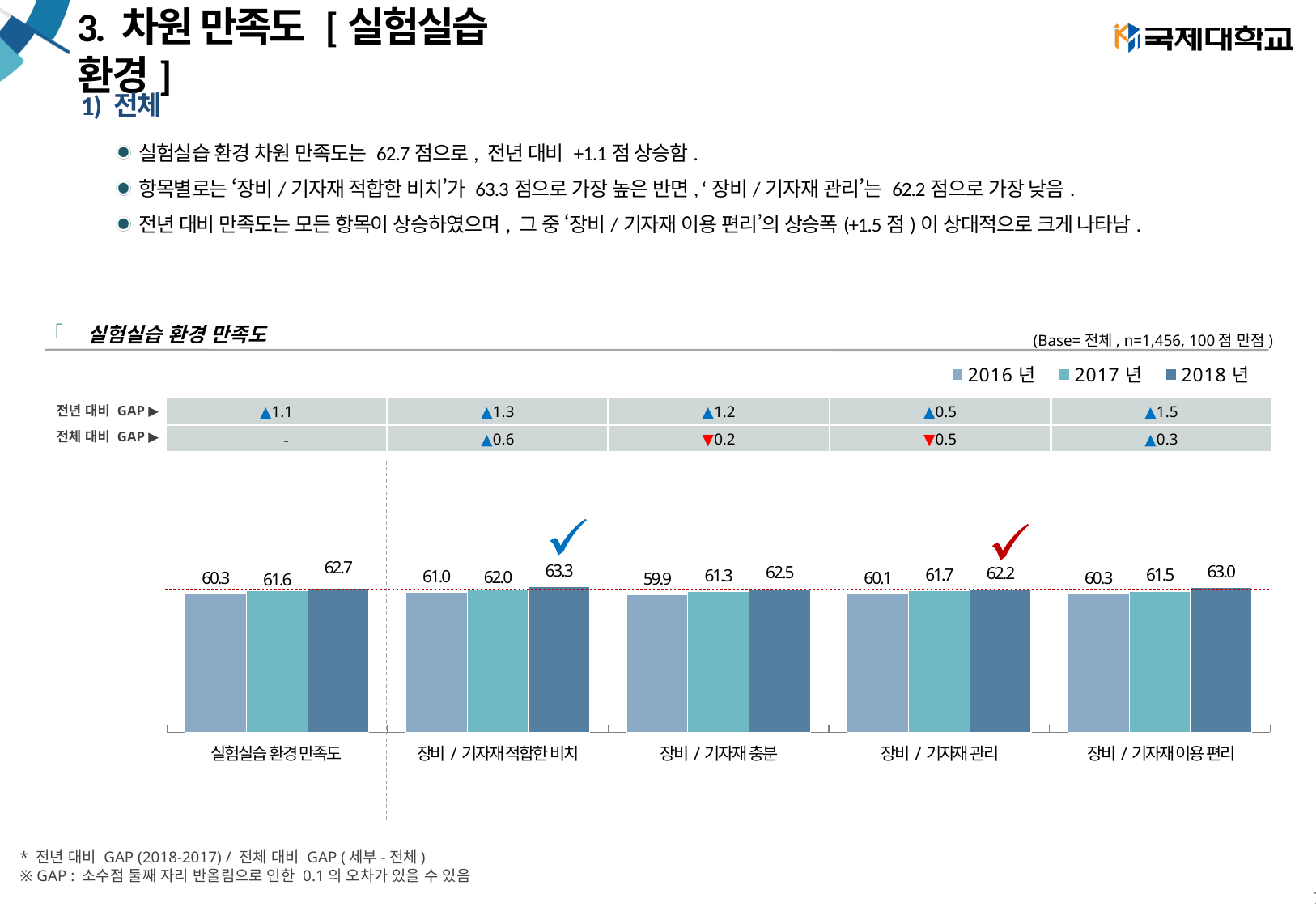
Which is larger, the 2018년 value for 장비/기자재 관리 or the 2018년 value for 장비/기자재 충분? 장비/기자재 충분 Which category has the highest 2018년 value? 장비/기자재 적합한 비치 How many series does the legend list? 3 What is the 2016년 value for 장비/기자재 충분? 59.9 What is the difference between the 2018년 and 2017년 values for 장비/기자재 이용 편리? 1.5 What is the 2018년 value for 장비/기자재 적합한 비치? 63.3 Which category has the lowest 2016년 value? 장비/기자재 충분 What is the 2017년 value for 실험실습 환경만족도? 61.6 What is the title of the chart? 실험실습 환경 만족도 What kind of chart is shown on the slide? Bar chart How many categories are shown on the x axis of the chart? 5 Do the values for 장비/기자재 관리 rise or fall from 2016년 to 2018년? Rise